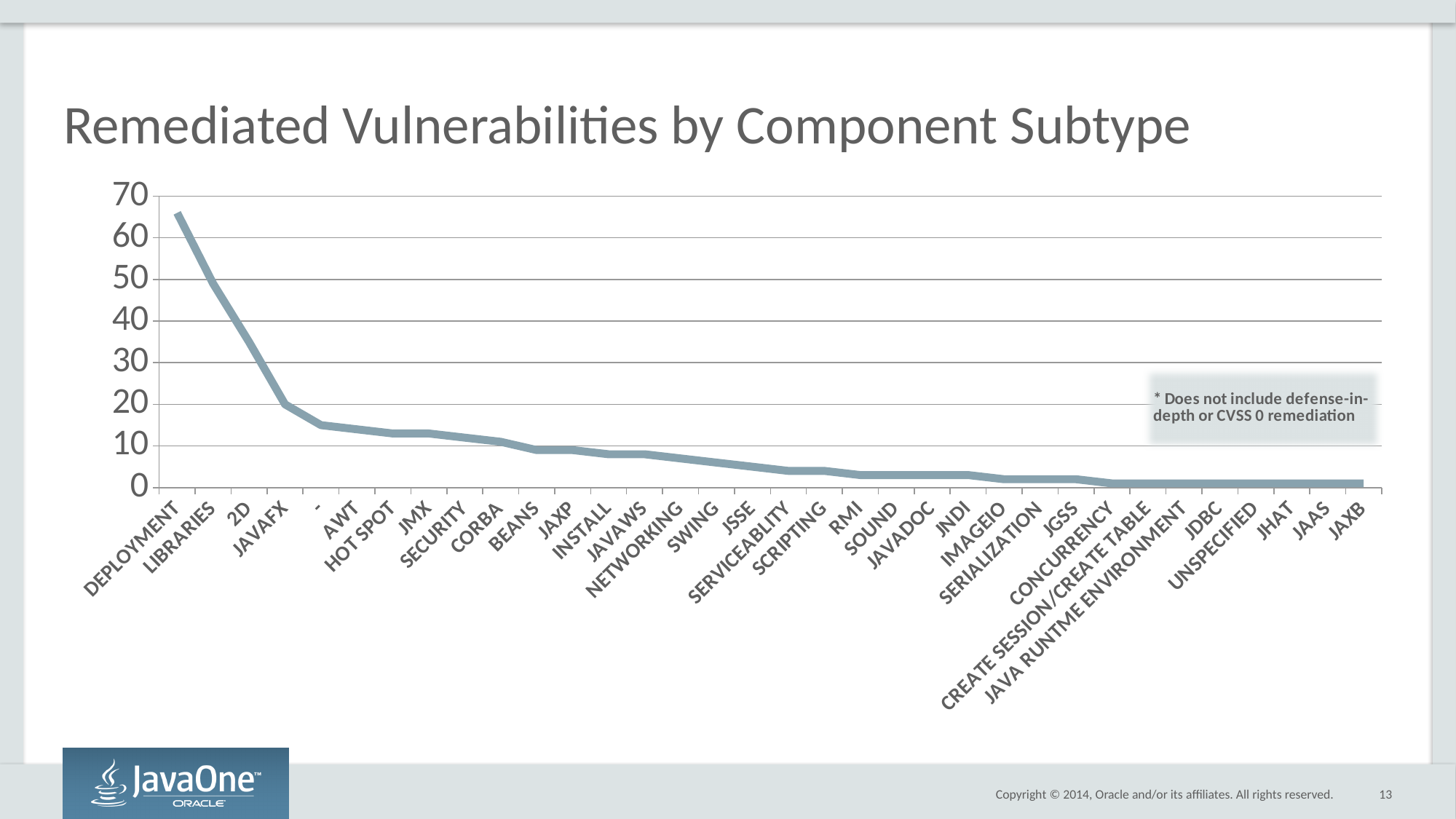
What is the title of the chart? Remediated Vulnerabilities by Component Subtype What kind of chart is shown on the slide? line chart Is the value for LIBRARIES greater or less than 30? greater Which component subtype has the highest number of remediated vulnerabilities? DEPLOYMENT What does the note on the chart say is not included? defense-in-depth or CVSS 0 remediation Is the value for JAVAFX greater or less than 10? greater Is the value for DEPLOYMENT greater or less than 60? greater Do the values rise or fall moving from left to right along the x axis? fall Which has more remediated vulnerabilities, AWT or JAXB? AWT Which has more remediated vulnerabilities, DEPLOYMENT or LIBRARIES? DEPLOYMENT